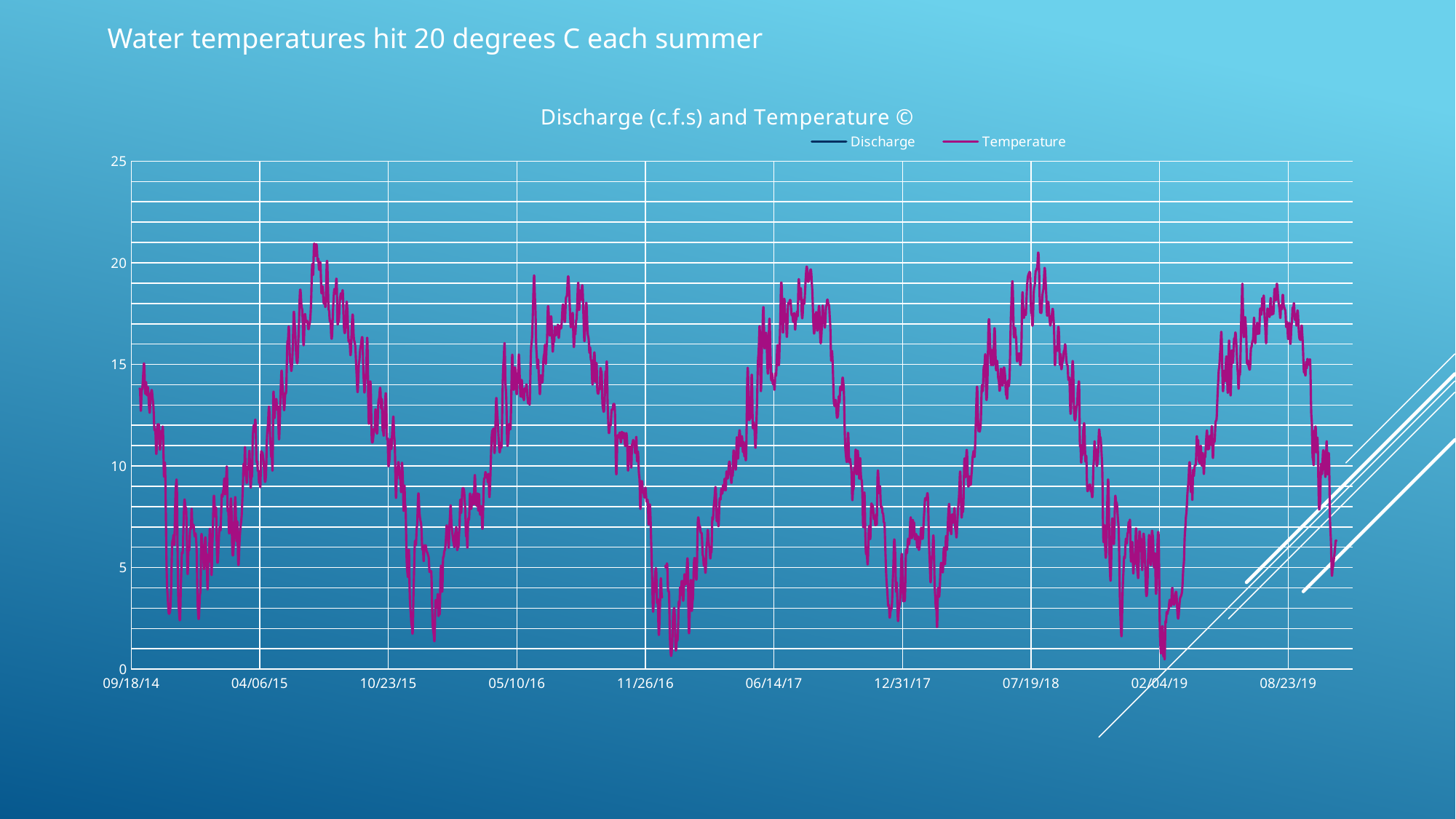
Does the Temperature series rise or fall between 02/04/19 and 08/23/19? rise What kind of chart is shown on the slide? line chart Does the Temperature series rise or fall between 07/19/18 and 02/04/19? fall Is the highest Temperature value on the chart greater or less than 25? less What is the title of the chart? Discharge (c.f.s) and Temperature © How many series does the legend list? 2 Is the Temperature value at 07/19/18 greater or less than 15? greater Is the Temperature value at 02/04/19 greater or less than 5? less What are the two series named in the legend? Discharge and Temperature How many date labels are shown on the x axis? 10